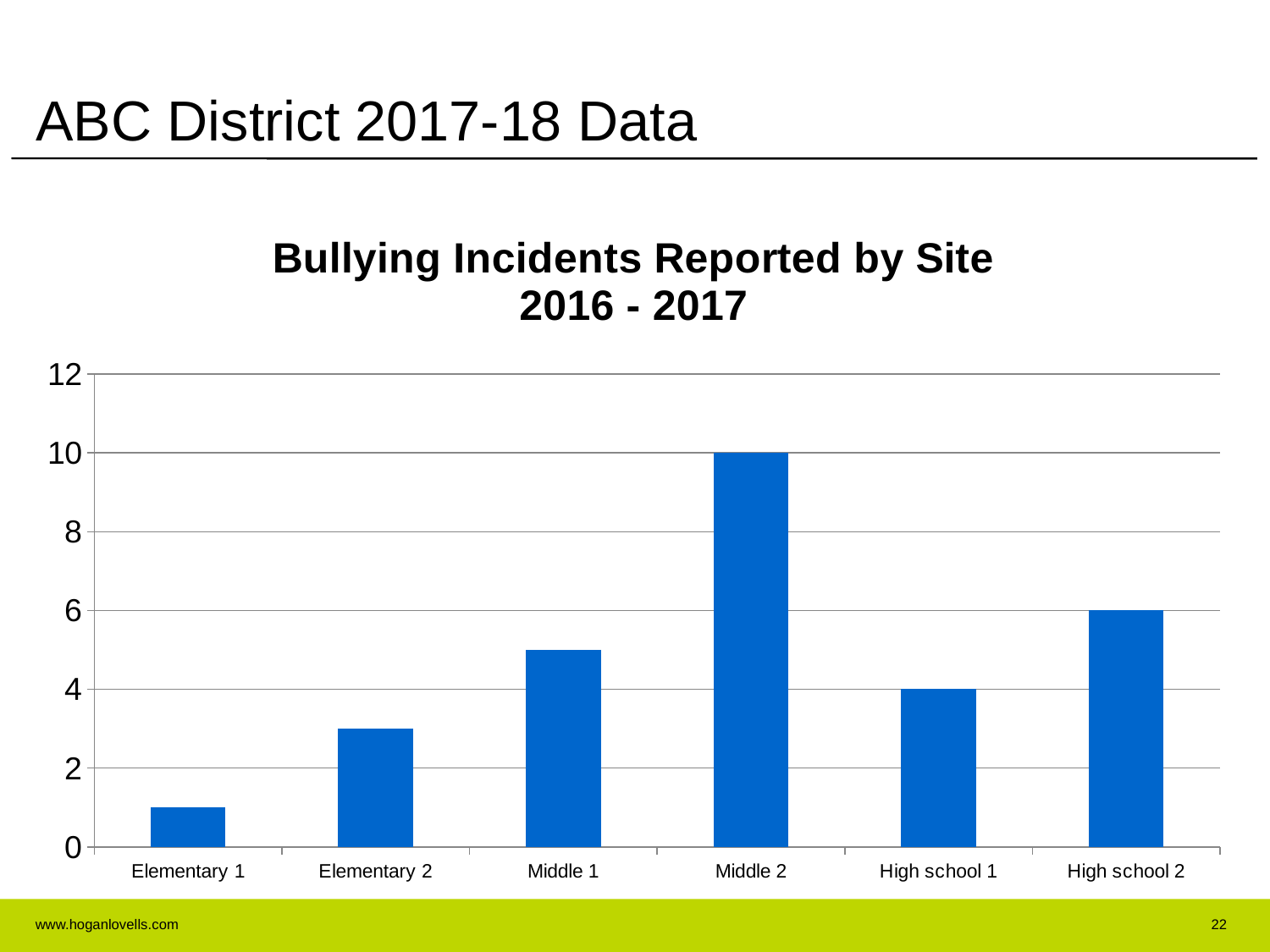
What is the difference between the number of incidents reported for Middle 2 and High school 2? 4 Which site has the highest number of bullying incidents reported? Middle 2 How many bullying incidents were reported for High school 1? 4 Which site has the lowest number of bullying incidents reported? Elementary 1 How many bullying incidents were reported for Middle 2? 10 What type of chart is shown on the slide? bar chart What is the title of the chart? Bullying Incidents Reported by Site 2016 - 2017 How many sites are shown on the x axis of the chart? 6 Is the value for Elementary 1 greater or less than 2? less Is the value for Middle 1 greater or less than 4? greater How many bullying incidents were reported for High school 2? 6 Which site reported more bullying incidents, High school 1 or High school 2? High school 2